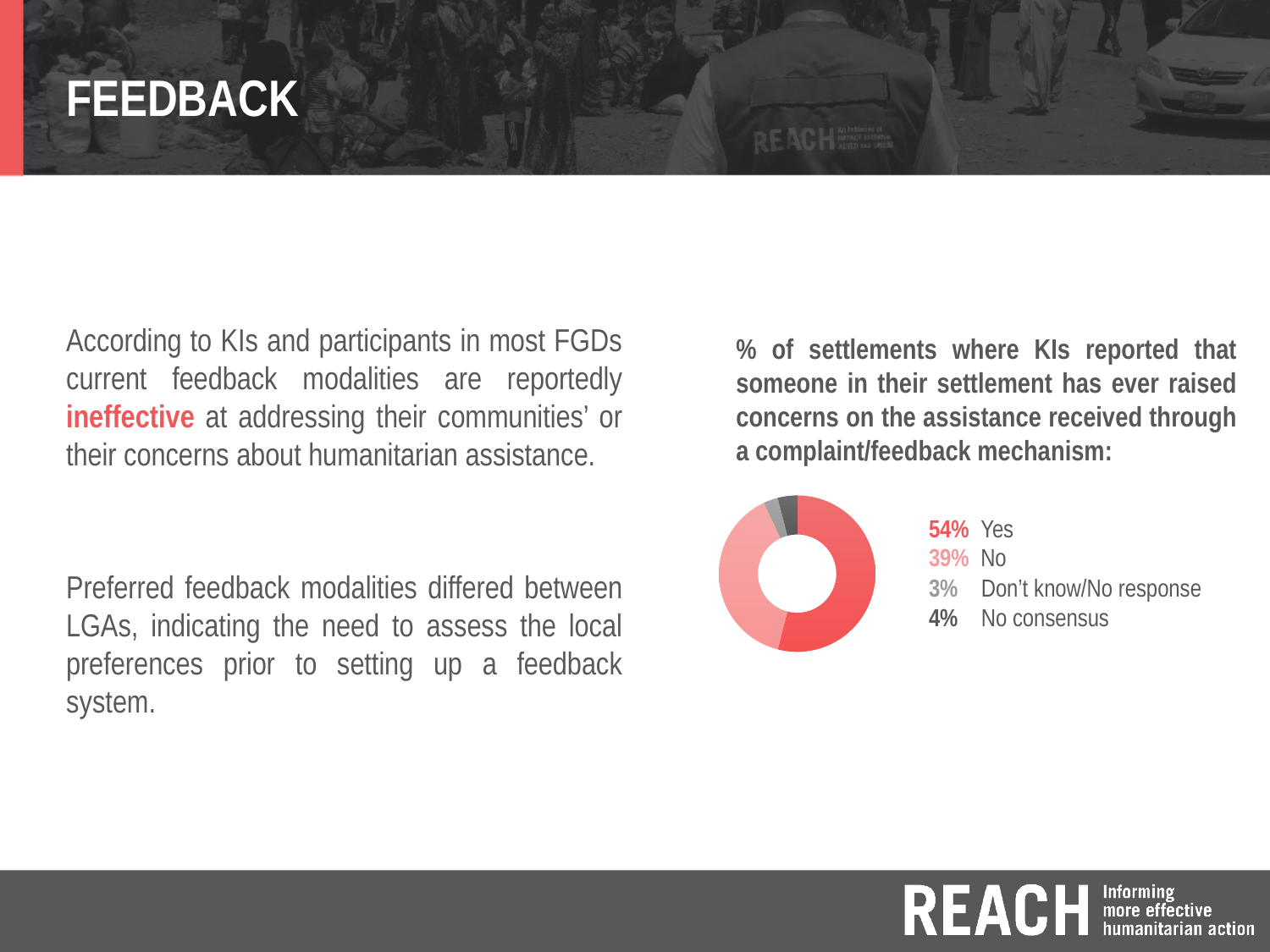
Is the share for 'Yes' greater or less than 50%? greater Which is larger, the share for 'No consensus' or the share for 'Don't know/No response'? No consensus What is the difference in percentage points between 'Yes' and 'No'? 15 Which category has the largest share of the pie? Yes What percentage is shown for 'No consensus'? 4% Which category has the smallest share of the pie? Don't know/No response What percentage is shown for 'Don't know/No response'? 3% How many categories does the pie chart show? 4 What kind of chart is shown on the slide? Pie chart (donut) What percentage of settlements reported 'No'? 39% What colour is the 'Yes' slice of the pie chart? Red What percentage of settlements reported 'Yes'? 54%